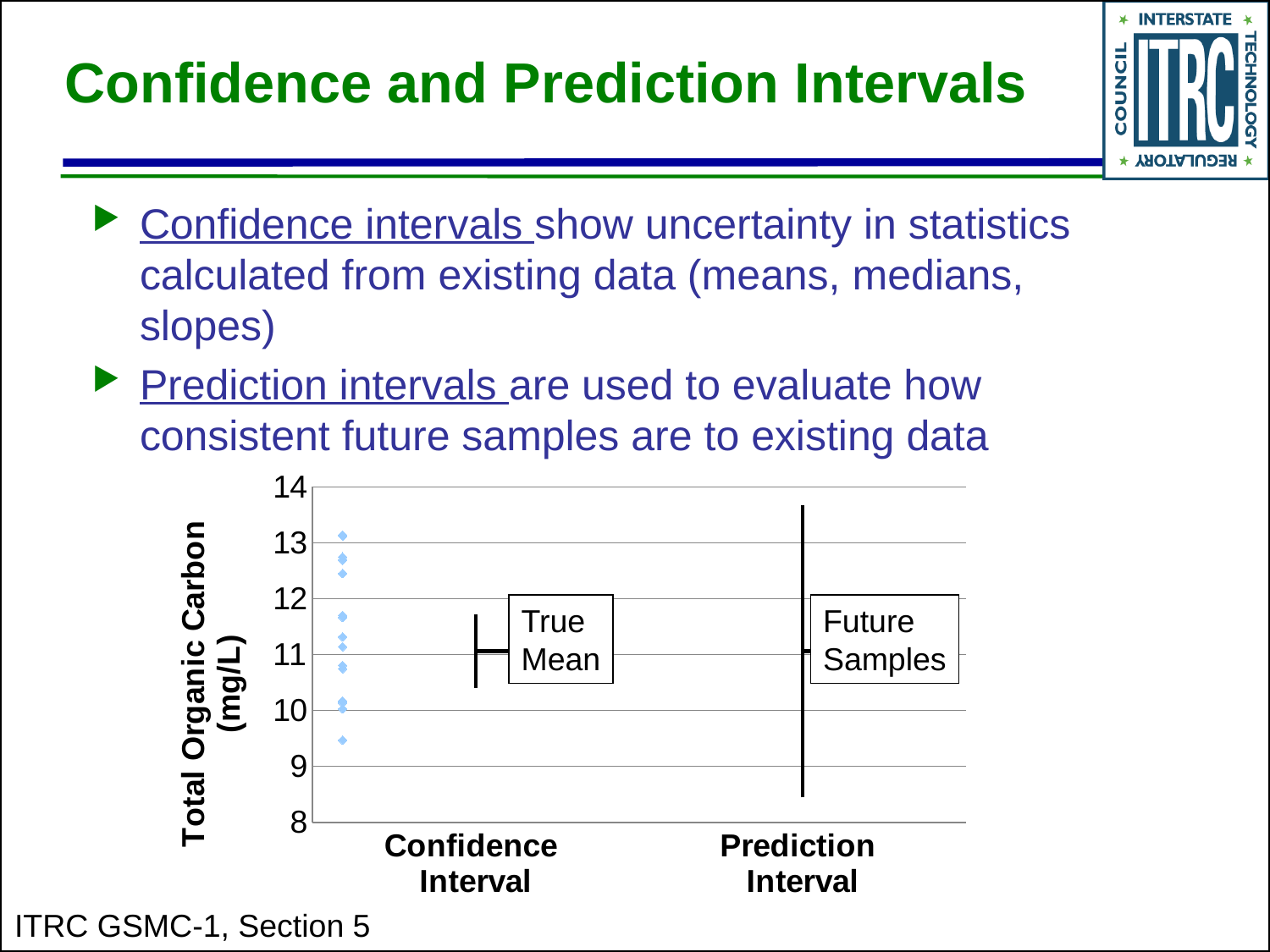
Which interval spans a wider range on the chart, the Confidence Interval or the Prediction Interval? Prediction Interval What are the two category labels on the x axis of the chart? Confidence Interval, Prediction Interval What is the lowest value shown on the y axis of the chart? 8 What label is attached to the Prediction Interval bar on the chart? Future Samples Is the lower end of the Prediction Interval bar greater or less than 9? less Is the lower end of the Confidence Interval bar greater or less than 10? greater What is the highest value shown on the y axis of the chart? 14 How many categories are shown on the x axis of the chart? 2 Is the upper end of the Confidence Interval bar greater or less than 12? less What label is attached to the Confidence Interval bar on the chart? True Mean What is the y-axis title of the chart? Total Organic Carbon (mg/L)